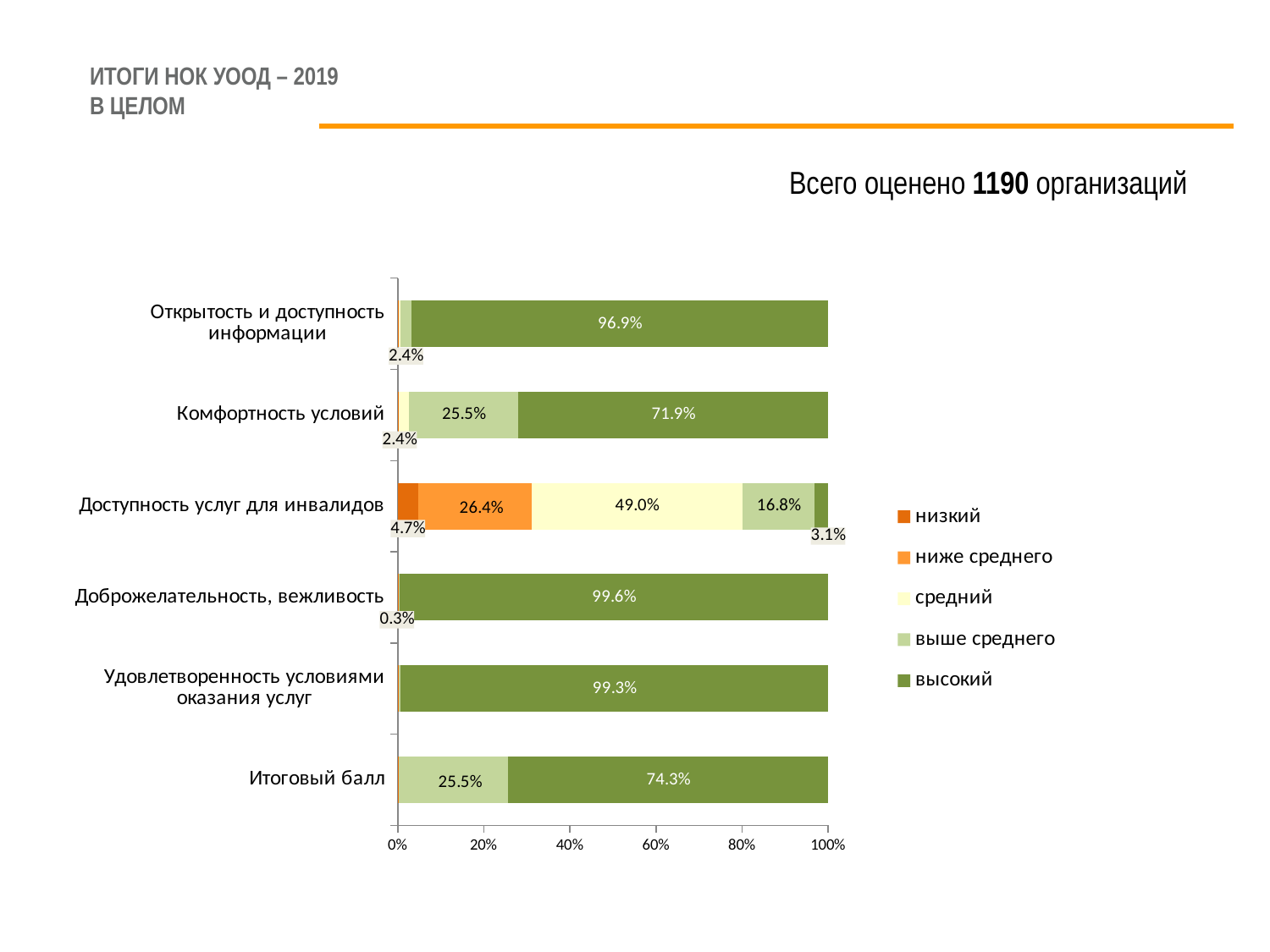
What is the value of the "ниже среднего" series for "Доступность услуг для инвалидов"? 26.4% What is the value of the "высокий" series for "Доброжелательность, вежливость"? 99.6% What is the value of the "выше среднего" series for "Итоговый балл"? 25.5% Which category has the highest value for the "высокий" series? Доброжелательность, вежливость How many series does the legend list? 5 For "Доступность услуг для инвалидов", which is larger: the "средний" value or the "ниже среднего" value? средний What kind of chart is shown on the slide? Stacked bar chart What is the value of the "высокий" series for "Открытость и доступность информации"? 96.9% How many categories are shown on the chart? 6 Which category has the lowest value for the "высокий" series? Доступность услуг для инвалидов What is the difference between the "высокий" values for "Итоговый балл" and "Комфортность условий"? 2.4% What is the value of the "средний" series for "Доступность услуг для инвалидов"? 49.0%